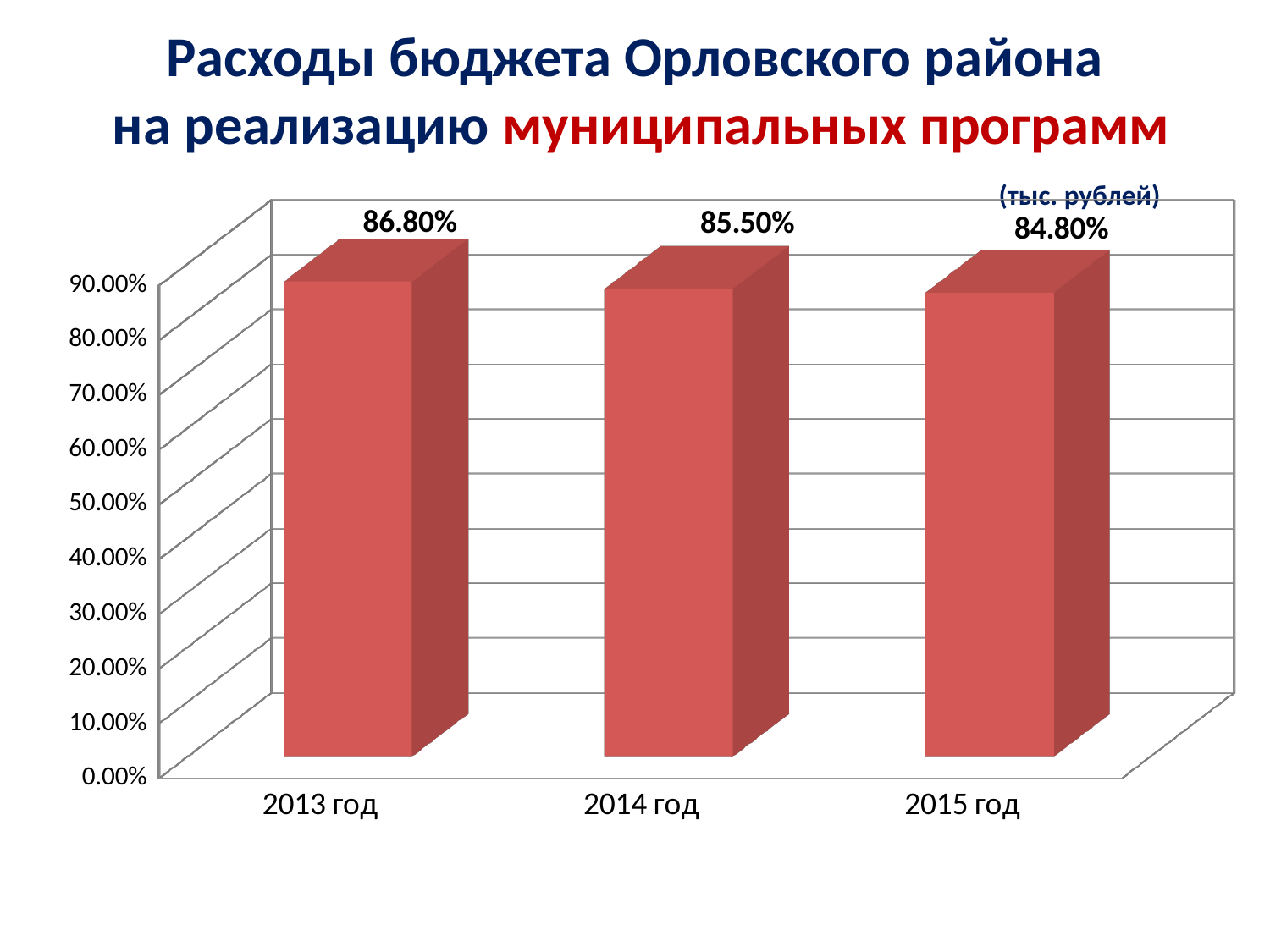
Do the values rise or fall from 2013 год to 2015 год? fall What is the value for 2015 год? 84.80% What is the difference between the values for 2013 год and 2015 год? 2.00% What is the difference between the values for 2013 год and 2014 год? 1.30% Which year has the highest value? 2013 год Is the value for 2015 год greater or less than 80.00%? greater What is the value for 2013 год? 86.80% What kind of chart is shown on the slide? bar chart What is the value for 2014 год? 85.50% Which is larger, the value for 2014 год or the value for 2015 год? 2014 год How many years are shown on the chart? 3 Which year has the lowest value? 2015 год